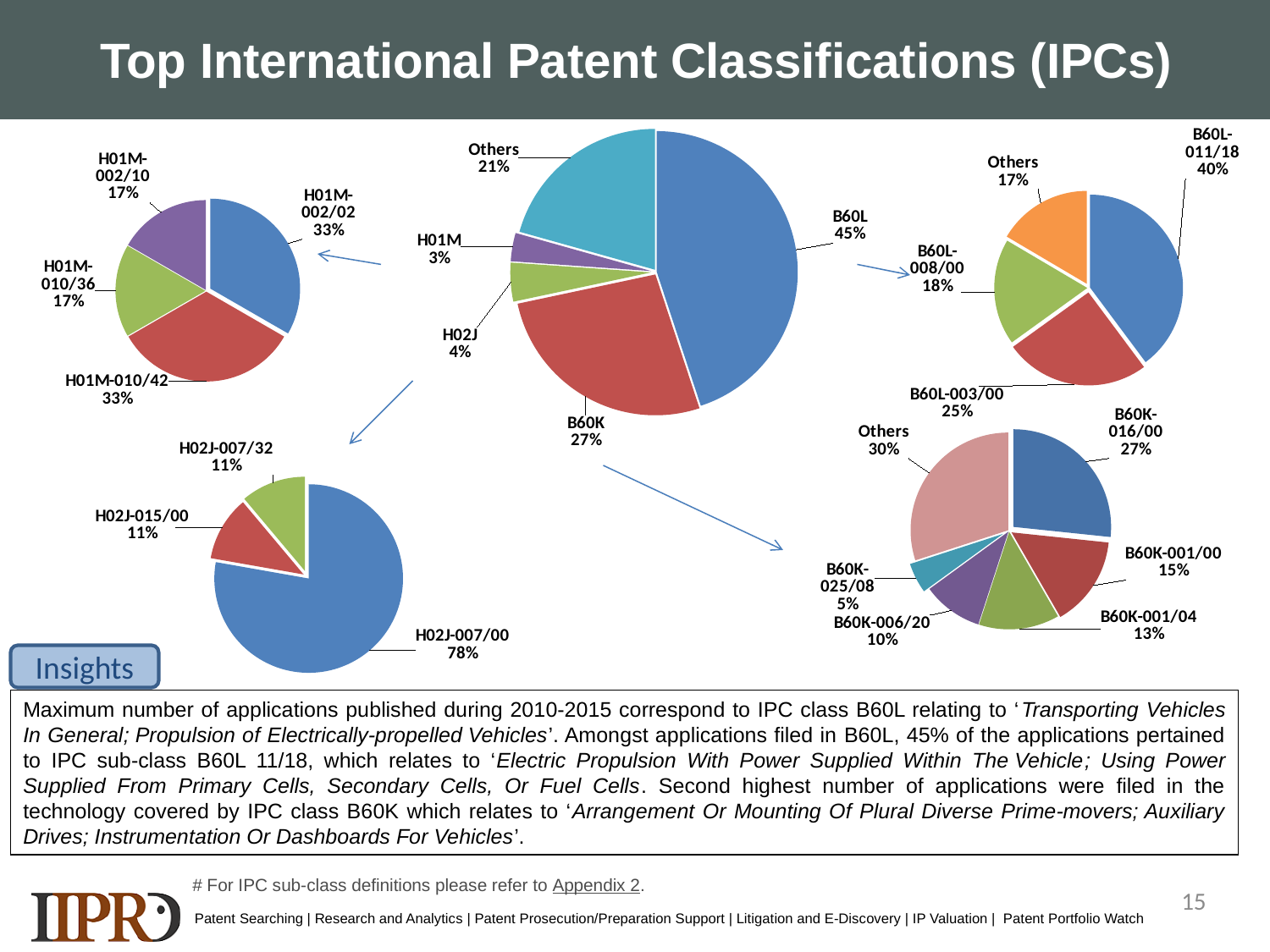
In the top-left pie chart, what share does H01M-010/36 have? 17% In the central pie chart, what share does B60L have? 45% In the central pie chart, which IPC class has the largest share? B60L In the top-right pie chart, which is larger: B60L-003/00 or B60L-008/00? B60L-003/00 How many slices does the central pie chart have? 5 In the top-right pie chart, what share does B60L-011/18 have? 40% In the central pie chart, what is the difference between the shares of B60L and B60K? 18% In the central pie chart, which labelled slice has the smallest share? H01M How many slices does the bottom-right pie chart have? 6 What type of chart is used on this slide? Pie chart In the bottom-right pie chart, which labelled sub-class (excluding Others) has the smallest share? B60K-025/08 In the bottom-left pie chart, what share does H02J-007/00 have? 78%